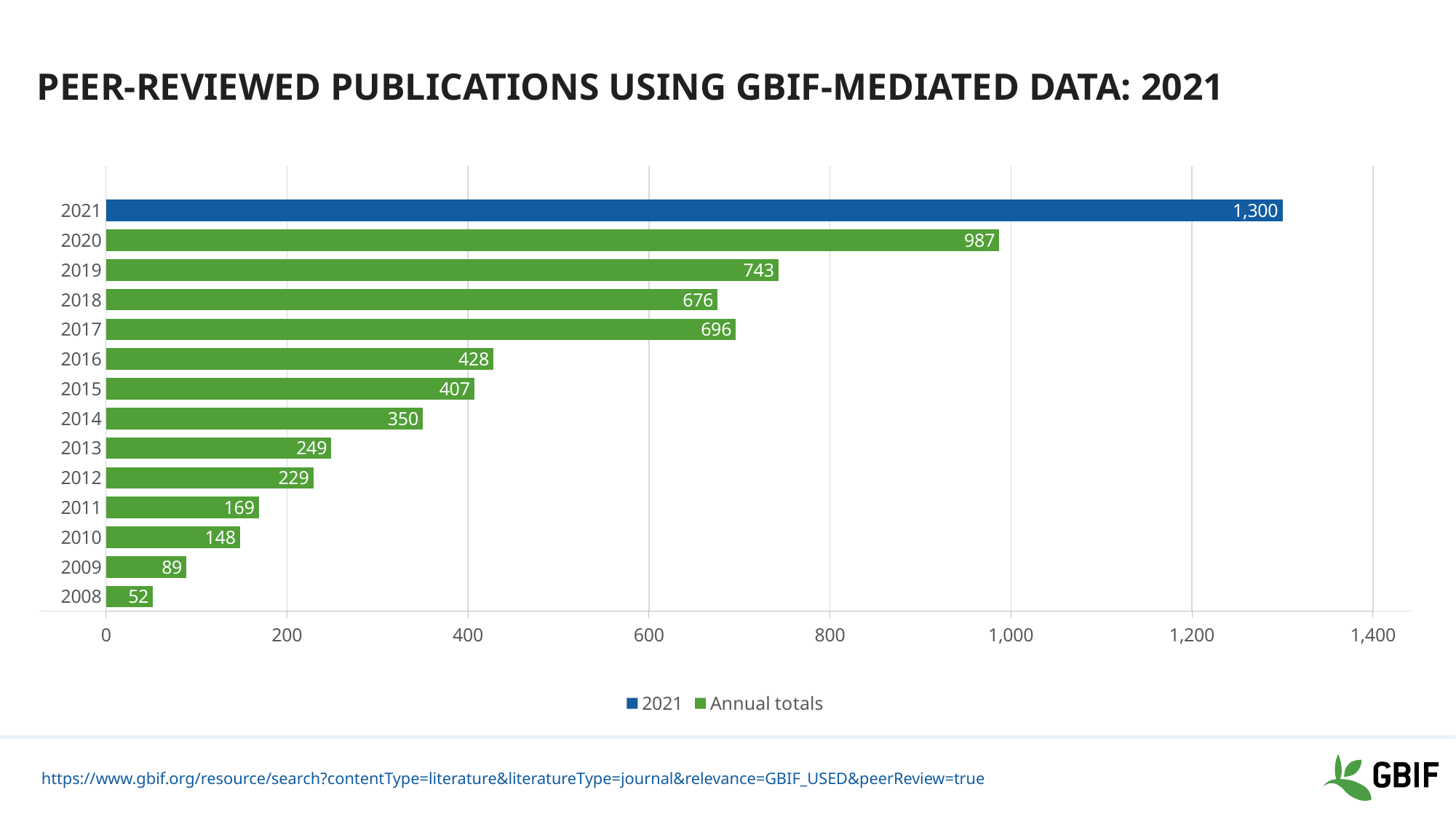
How many years are shown on the chart? 14 What is the value for 2008? 52 Is the value for 2019 greater or less than 600? greater How many series does the legend list? 2 What is the title of the chart? PEER-REVIEWED PUBLICATIONS USING GBIF-MEDIATED DATA: 2021 What is the difference between the values for 2021 and 2020? 313 What kind of chart is shown? bar chart Which year has the lowest value? 2008 What is the value for 2017? 696 Which is larger, the value for 2017 or the value for 2018? 2017 Which year has the highest value? 2021 What is the value for 2021? 1,300